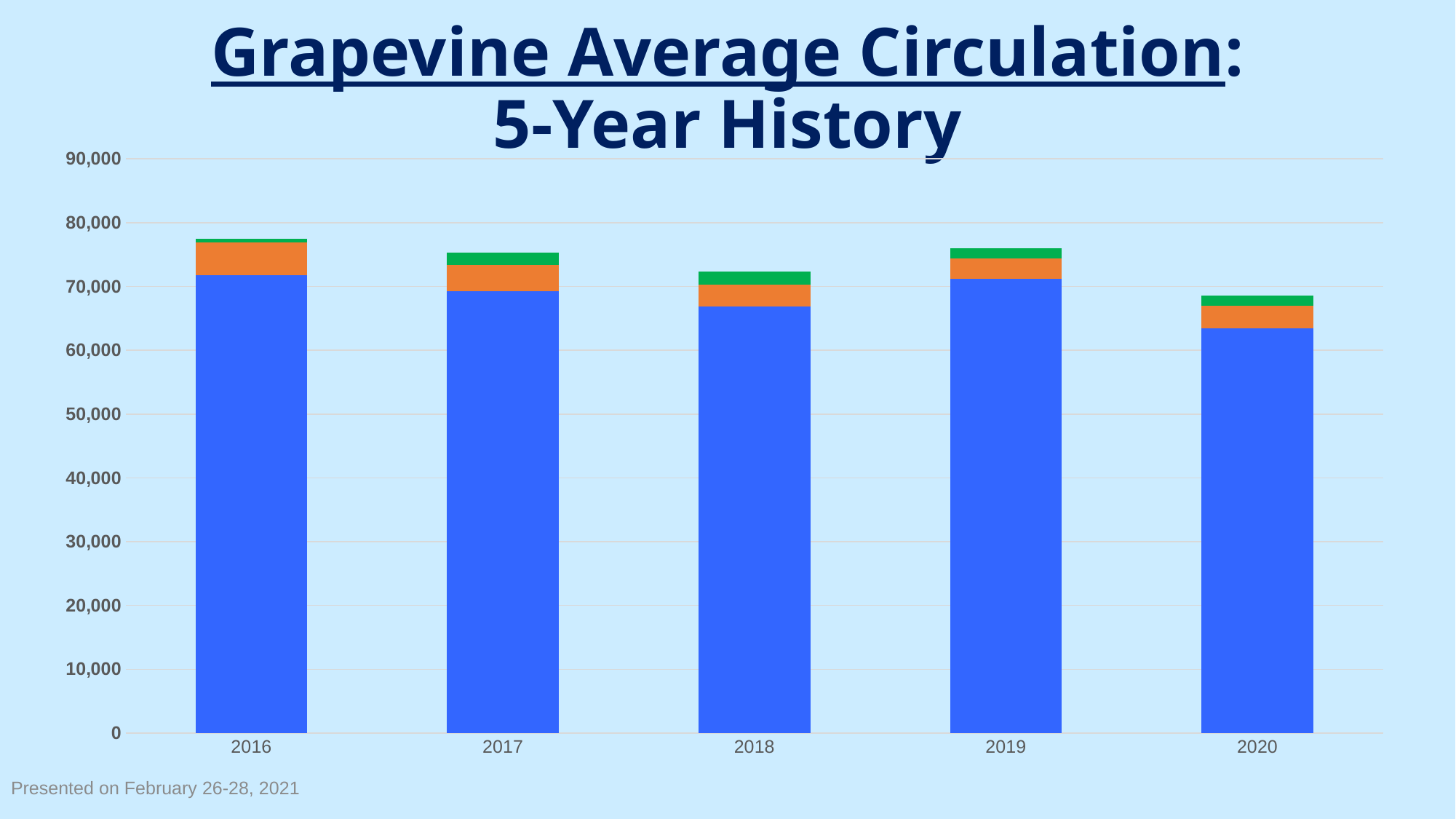
What is the title of the chart? Grapevine Average Circulation: 5-Year History Is the total bar height for 2016 greater or less than 70,000? greater How many years are shown on the x axis of the chart? 5 Which year has the shortest stacked bar? 2020 Which year has the taller stacked bar, 2018 or 2019? 2019 What kind of chart is shown on the slide? bar chart Is the total bar height for 2020 greater or less than 70,000? less Which year has the taller stacked bar, 2016 or 2020? 2016 Is the blue segment for 2020 greater or less than 60,000? greater How many coloured segments make up each stacked bar? 3 Which year has the tallest stacked bar? 2016